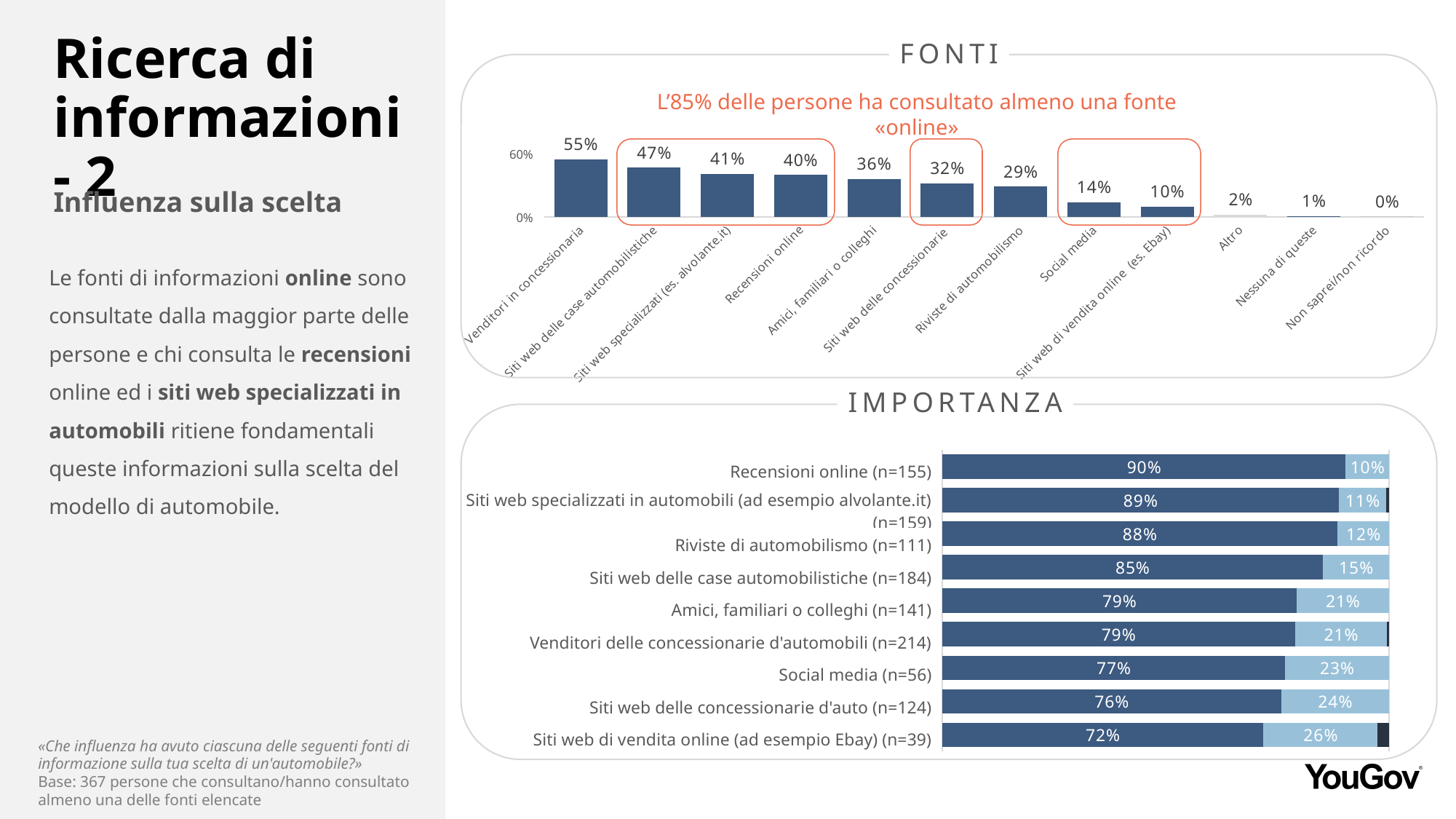
In the FONTI chart, which category has the lowest value? Non saprei/non ricordo In the FONTI chart, what is the value for Recensioni online? 40% In the FONTI chart, which is larger: Amici, familiari o colleghi or Riviste di automobilismo? Amici, familiari o colleghi In the FONTI chart, which category has the highest value? Venditori in concessionaria In the IMPORTANZA chart, what is the value of the dark blue segment for Social media (n=56)? 77% In the FONTI chart, what is the difference between Siti web delle case automobilistiche and Social media? 33% How many categories are shown in the IMPORTANZA chart? 9 In the IMPORTANZA chart, what is the value of the light blue segment for Siti web di vendita online (ad esempio Ebay) (n=39)? 26% How many categories are shown in the FONTI chart? 12 In the IMPORTANZA chart, which category has the highest dark blue value? Recensioni online (n=155) In the FONTI chart, what is the value for Venditori in concessionaria? 55% What kind of chart is the FONTI chart? Bar chart